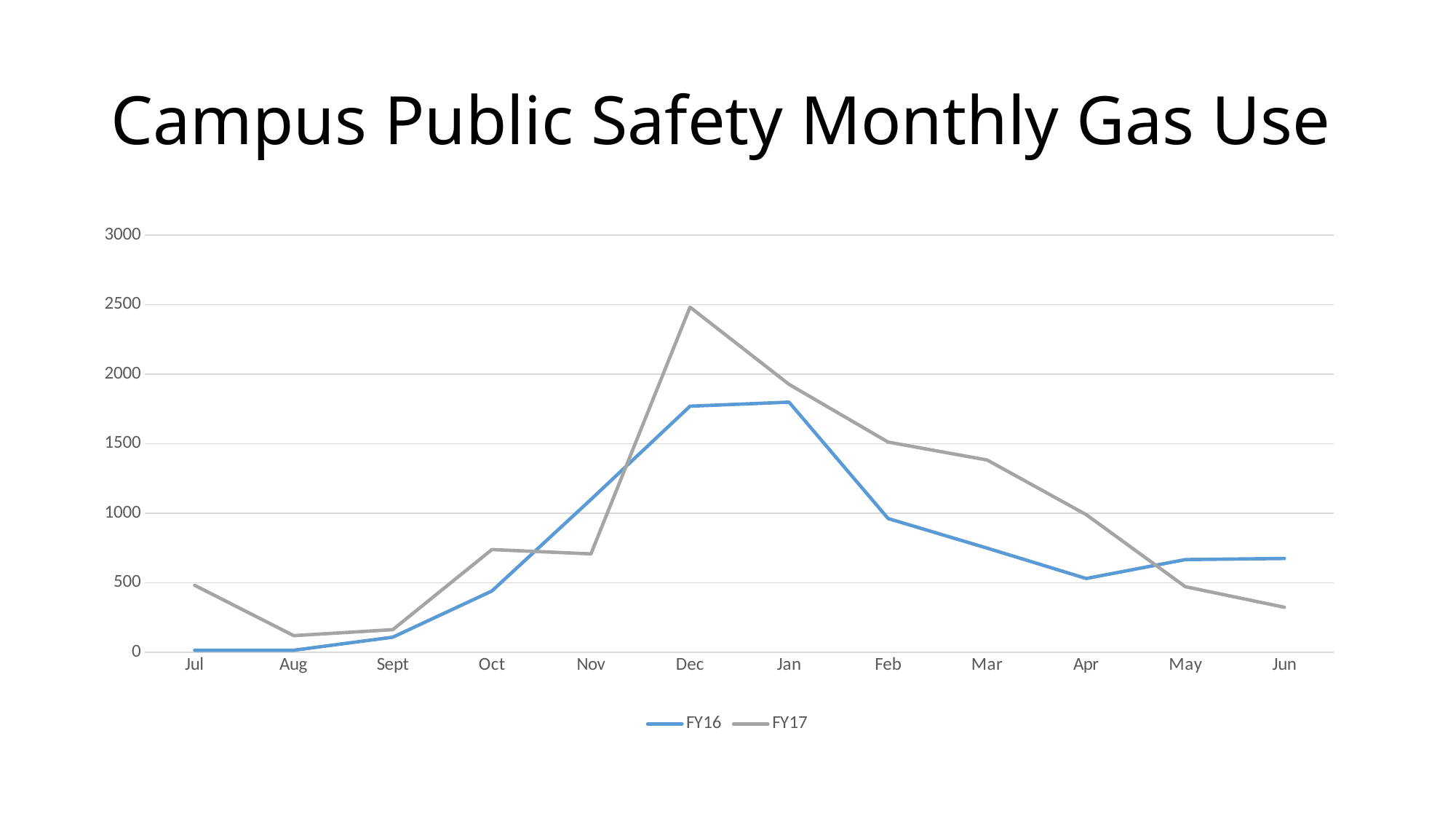
Is the FY17 value for Dec greater or less than 2000? greater How many series does the legend list? 2 In which month does the FY17 series reach its highest value? Dec Is the FY16 value for Dec greater or less than 2000? less What kind of chart is shown on the slide? line chart How many months are plotted along the x axis? 12 In which month is the FY17 series at its lowest value? Aug What is the title of the chart? Campus Public Safety Monthly Gas Use Does the FY17 series rise or fall from Dec to Jun? fall Is the FY17 value for Mar greater or less than 1000? greater In May, which series has the larger value, FY16 or FY17? FY16 In Feb, which series has the larger value, FY16 or FY17? FY17